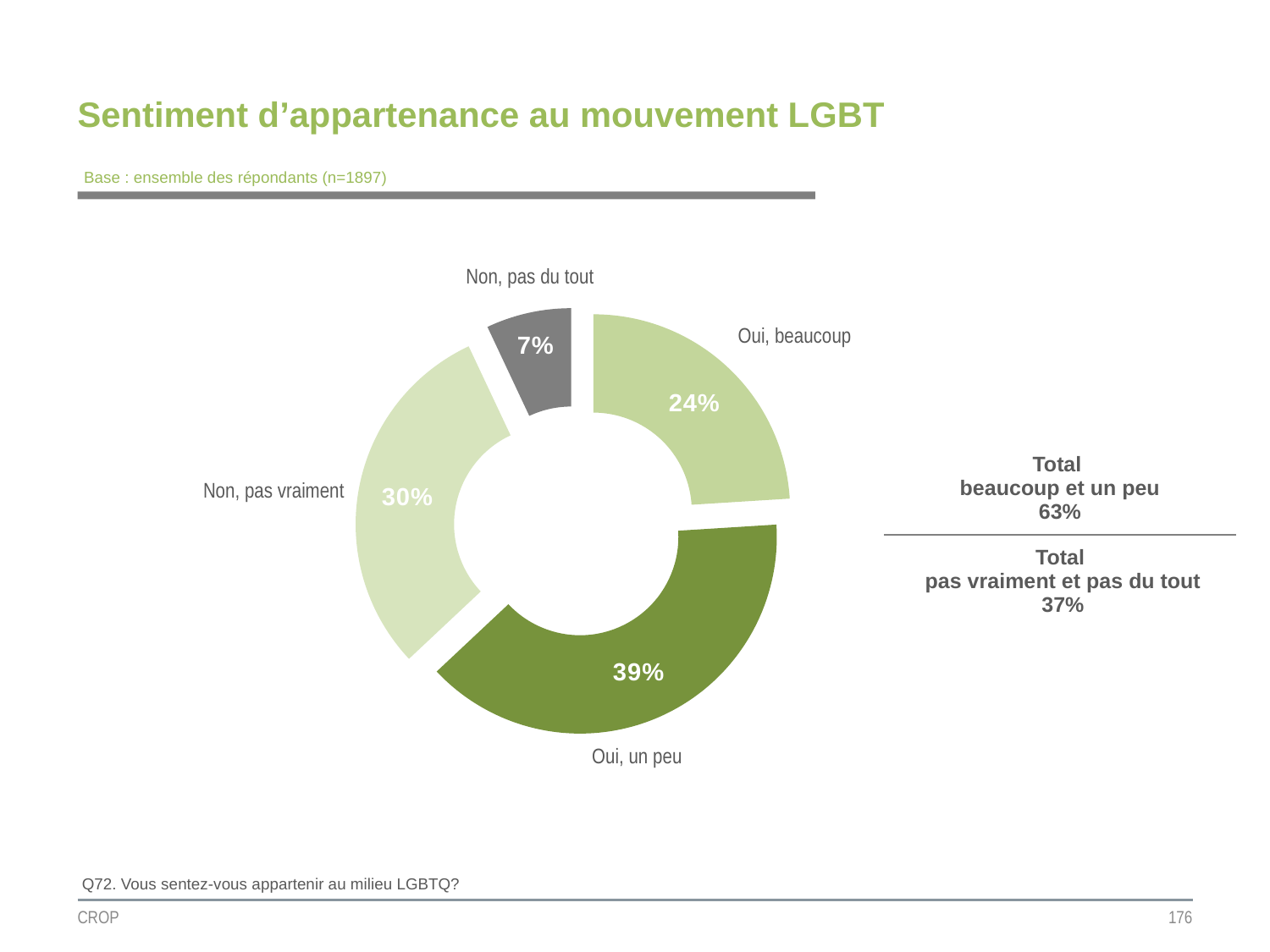
Which response category has the smallest share? Non, pas du tout What is the title of the chart on the slide? Sentiment d'appartenance au mouvement LGBT What percentage of respondents answered "Oui, un peu"? 39% What percentage of respondents answered "Non, pas du tout"? 7% What is the combined total shown for "beaucoup et un peu"? 63% What kind of chart is shown on the slide? Pie chart (doughnut) Which response category has the largest share? Oui, un peu What percentage of respondents answered "Non, pas vraiment"? 30% What is the difference in percentage points between "Oui, un peu" and "Oui, beaucoup"? 15 What percentage of respondents answered "Oui, beaucoup"? 24% Which is larger: the share for "Non, pas vraiment" or the share for "Oui, beaucoup"? Non, pas vraiment How many response categories are shown in the chart? 4